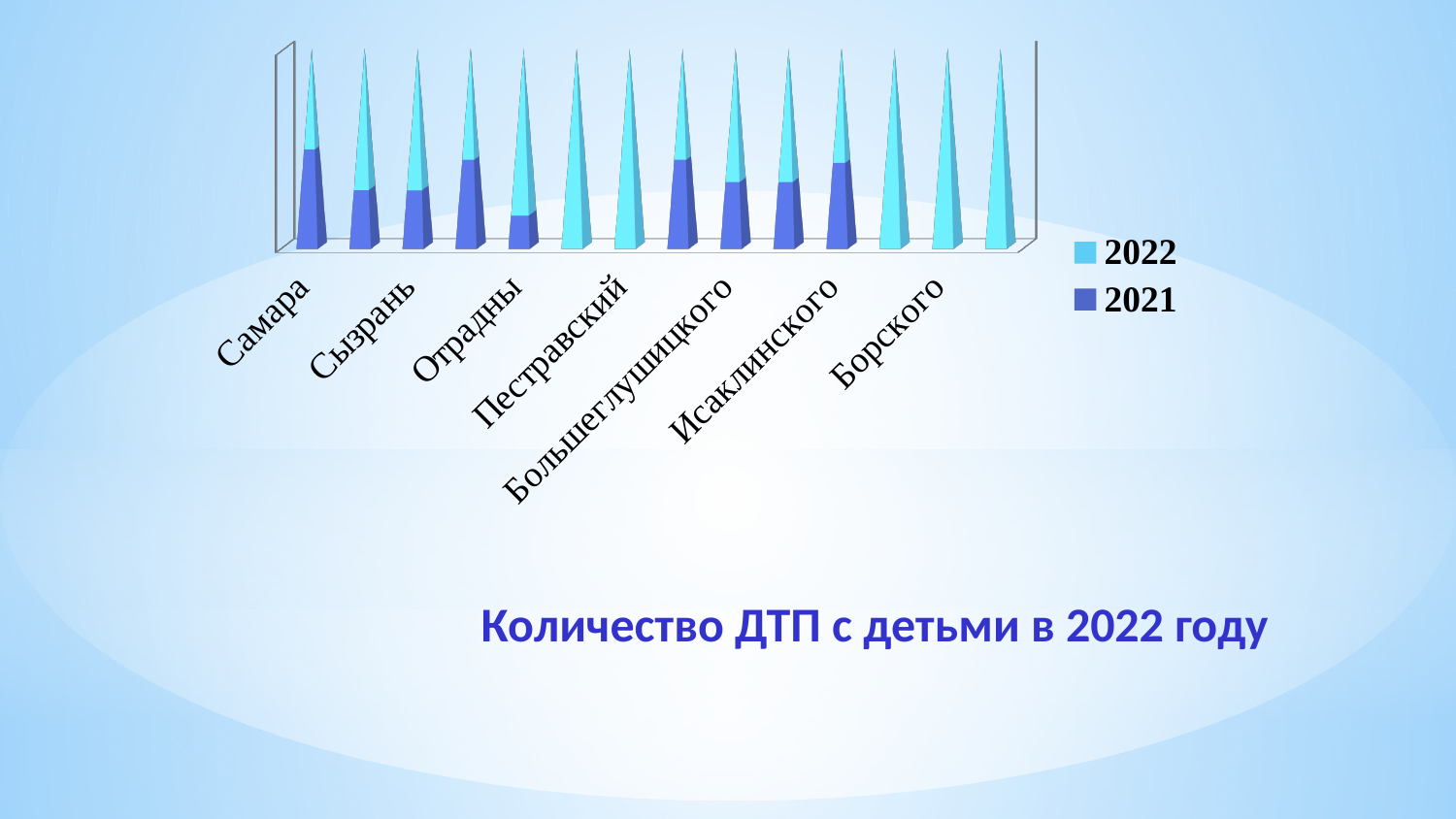
What are the two series named in the legend? 2022 and 2021 Which is larger, the 2021 value for Отрадны or the 2021 value for Сызрань? Сызрань What caption is printed below the chart? Количество ДТП с детьми в 2022 году What kind of chart is shown on the slide? bar chart Which is larger, the 2021 value for Самара or the 2021 value for Сызрань? Самара How many category labels are shown along the x axis? 7 How many series does the legend list? 2